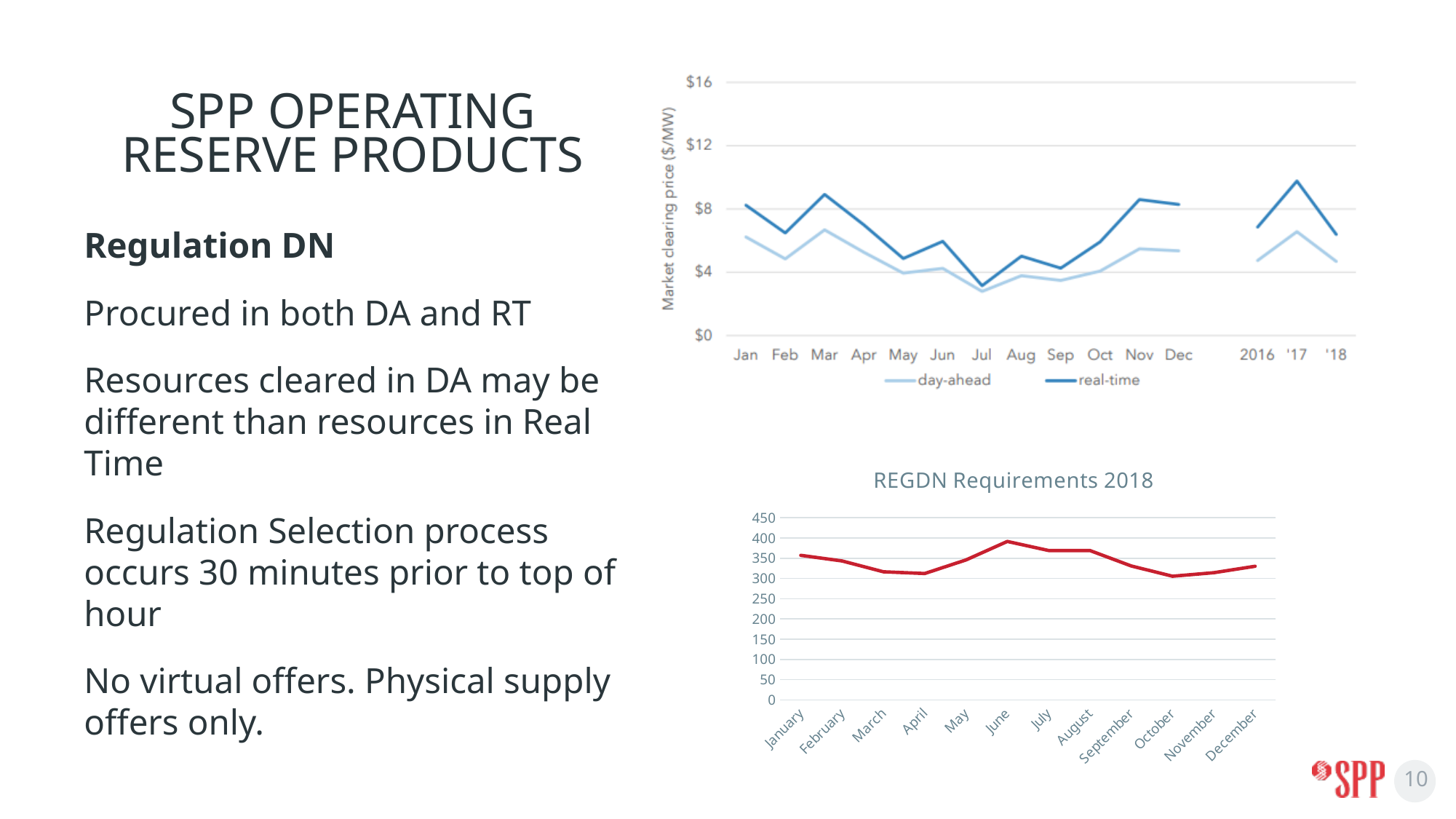
In the bottom chart 'REGDN Requirements 2018', do the values rise or fall from June to October? fall In the bottom chart 'REGDN Requirements 2018', is the value for June greater or less than 350? greater In the top market clearing price chart, is the day-ahead value for Jul greater or less than $4? less In the bottom chart 'REGDN Requirements 2018', is the value for October greater or less than 350? less In the top market clearing price chart, which of the years 2016, '17 and '18 has the highest real-time value? '17 How many months are plotted on the x axis of the bottom chart 'REGDN Requirements 2018'? 12 In the bottom chart 'REGDN Requirements 2018', which month has the highest value? June How many series does the legend of the top market clearing price chart list? 2 In the top market clearing price chart, which month has the lowest real-time value? Jul In the top market clearing price chart, which is larger in Mar, the day-ahead or the real-time value? real-time What kind of chart is the bottom chart titled 'REGDN Requirements 2018'? line chart